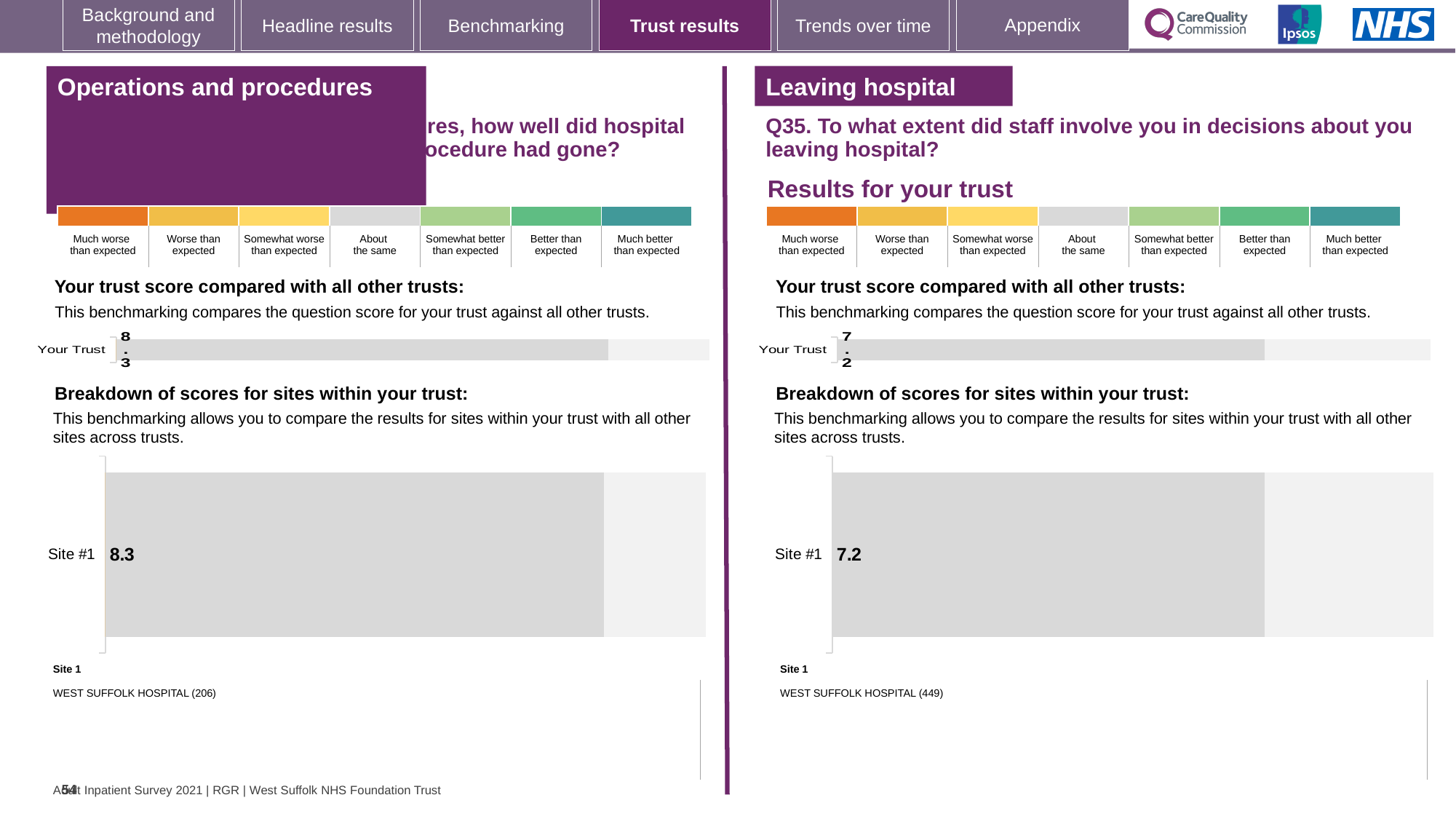
On the right-hand 'Leaving hospital' section, what is the score shown for Your Trust in the 'Your trust score compared with all other trusts' chart? 7.2 How many sites are plotted in the 'Breakdown of scores for sites within your trust' chart on the right-hand 'Leaving hospital' section? 1 In the 'Breakdown of scores for sites within your trust' chart on the right-hand 'Leaving hospital' section, what is the score for Site #1? 7.2 On the left-hand 'Operations and procedures' section, what is the score shown for Your Trust in the 'Your trust score compared with all other trusts' chart? 8.3 What kind of chart is used to show the Site #1 score in the 'Breakdown of scores for sites within your trust' section on the left? Bar chart In the 'Breakdown of scores for sites within your trust' chart on the left-hand 'Operations and procedures' section, what is the score for Site #1? 8.3 What is the difference between the Site #1 score in the left-hand 'Operations and procedures' breakdown chart and the Site #1 score in the right-hand 'Leaving hospital' breakdown chart? 1.1 How many categories are plotted in the 'Your trust score compared with all other trusts' chart on the left-hand 'Operations and procedures' section? 1 Which site is listed as Site 1 beneath the breakdown chart on the left-hand 'Operations and procedures' section? WEST SUFFOLK HOSPITAL (206) Which site is listed as Site 1 beneath the breakdown chart on the right-hand 'Leaving hospital' section? WEST SUFFOLK HOSPITAL (449) Which is larger: the Your Trust score in the left-hand 'Operations and procedures' chart or the Your Trust score in the right-hand 'Leaving hospital' chart? Operations and procedures (8.3)